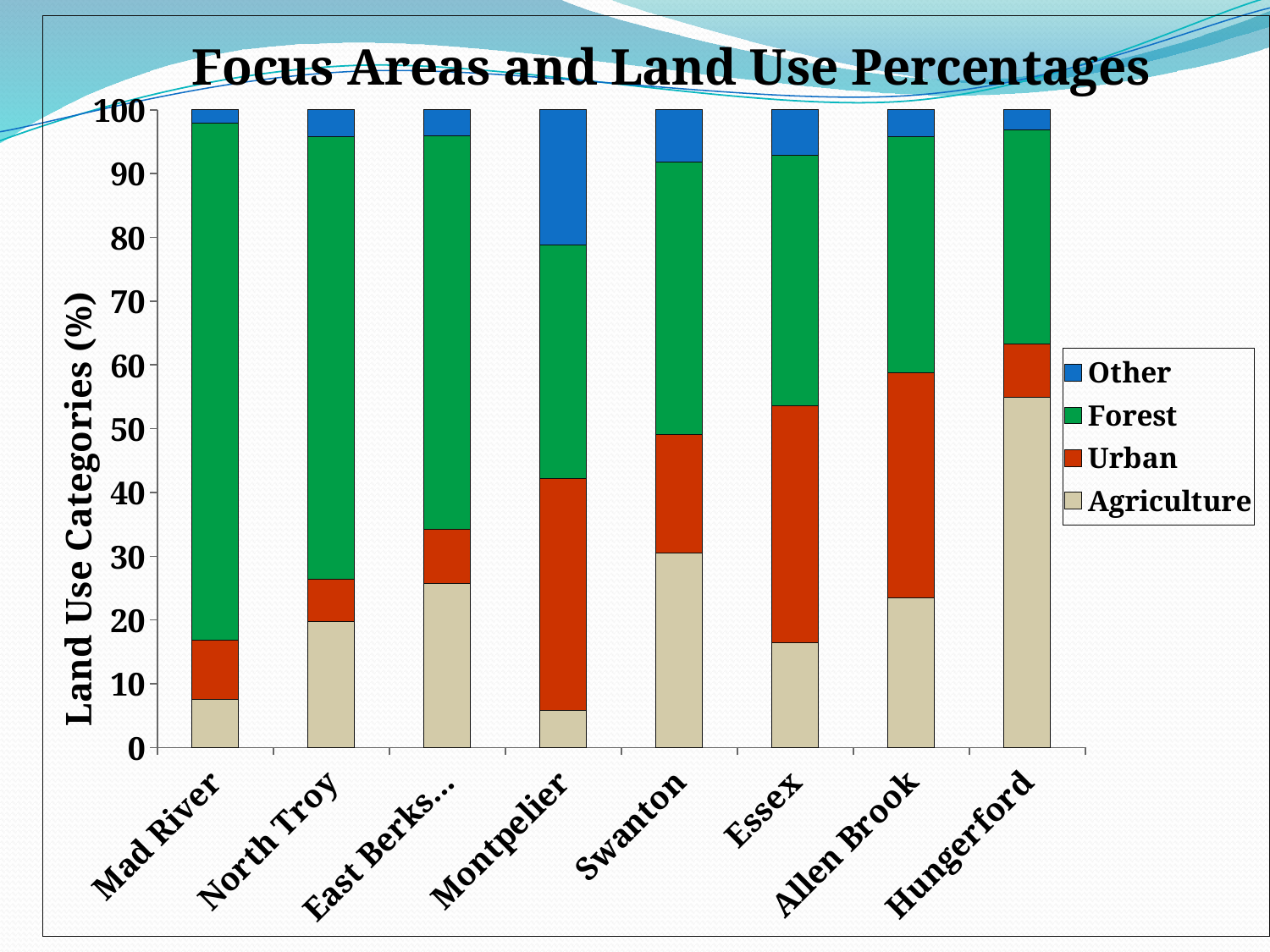
Is the Agriculture value for Mad River greater or less than 10? less What is the title of the chart? Focus Areas and Land Use Percentages What kind of chart is shown on the slide? Stacked bar chart How many focus areas are shown along the x axis? 8 How many series does the legend list? 4 Which focus area has the largest Other share? Montpelier Which focus area has the largest Forest share? Mad River Is the Agriculture value for Hungerford greater or less than 50? greater What is the label on the vertical axis? Land Use Categories (%) Which has the larger Forest share, Mad River or Hungerford? Mad River What is the total of the stacked bar for Swanton? 100 Which focus area has the largest Agriculture share? Hungerford